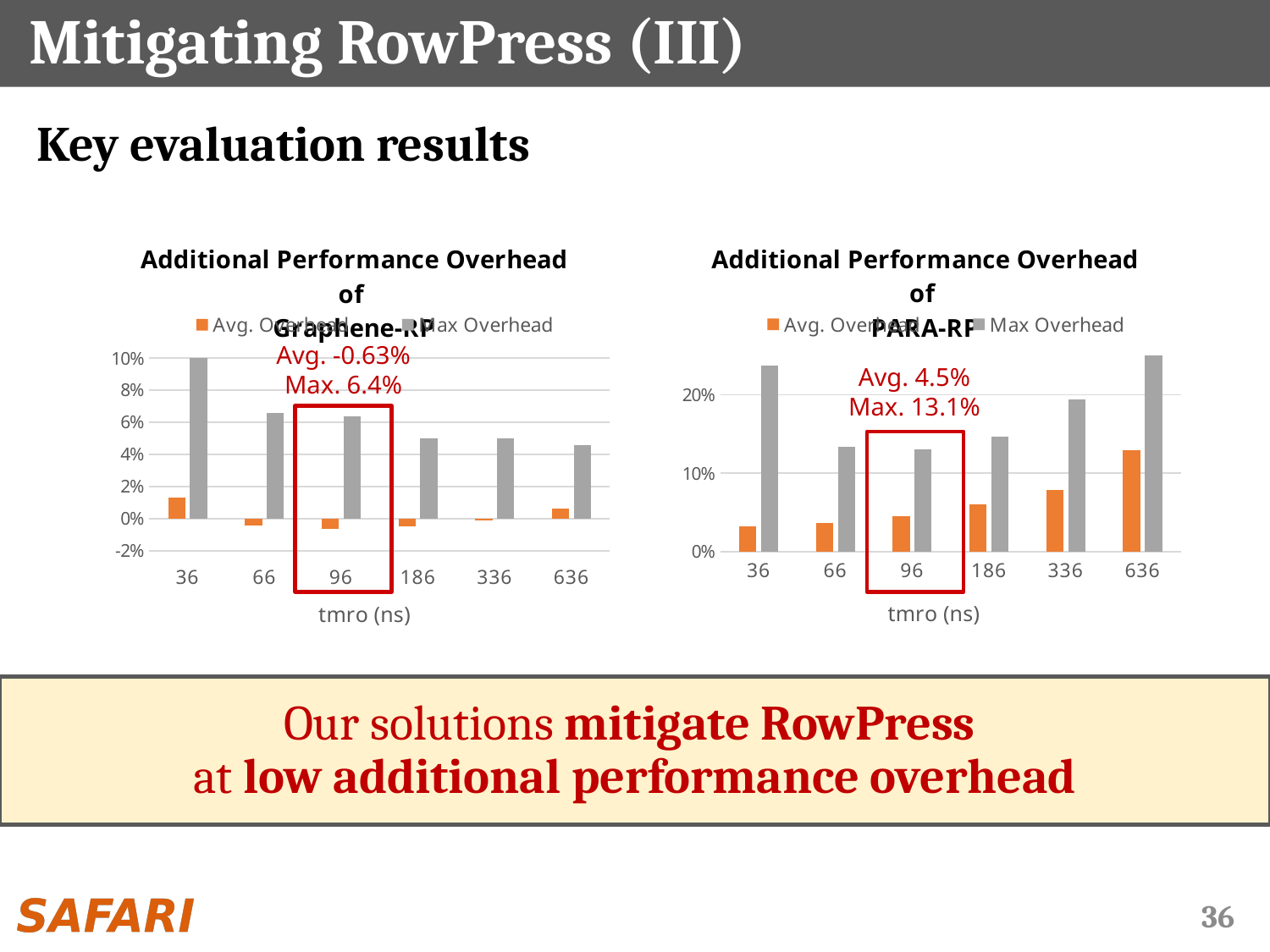
In the 'Additional Performance Overhead of PARA-RP' chart, is the Avg. Overhead at tmro 636 greater or less than 10%? greater In the 'Additional Performance Overhead of PARA-RP' chart, which has the larger Max Overhead: tmro 186 or tmro 336? 336 What is the x-axis label on the 'Additional Performance Overhead of Graphene-RP' chart? tmro (ns) In the 'Additional Performance Overhead of Graphene-RP' chart, is the Max Overhead at tmro 36 greater or less than 8%? greater In the 'Additional Performance Overhead of Graphene-RP' chart, at which tmro value is the Max Overhead highest? 36 In the 'Additional Performance Overhead of PARA-RP' chart, at which tmro value is the Avg. Overhead lowest? 36 In the 'Additional Performance Overhead of PARA-RP' chart, does the Avg. Overhead rise or fall as tmro increases from 36 to 636? rises What kind of chart is the 'Additional Performance Overhead of Graphene-RP' chart? bar chart How many tmro (ns) categories are shown on the x axis of the 'Additional Performance Overhead of PARA-RP' chart? 6 In the 'Additional Performance Overhead of Graphene-RP' chart, is the Avg. Overhead at tmro 36 greater or less than 2%? less How many series does the legend of the 'Additional Performance Overhead of Graphene-RP' chart list? 2